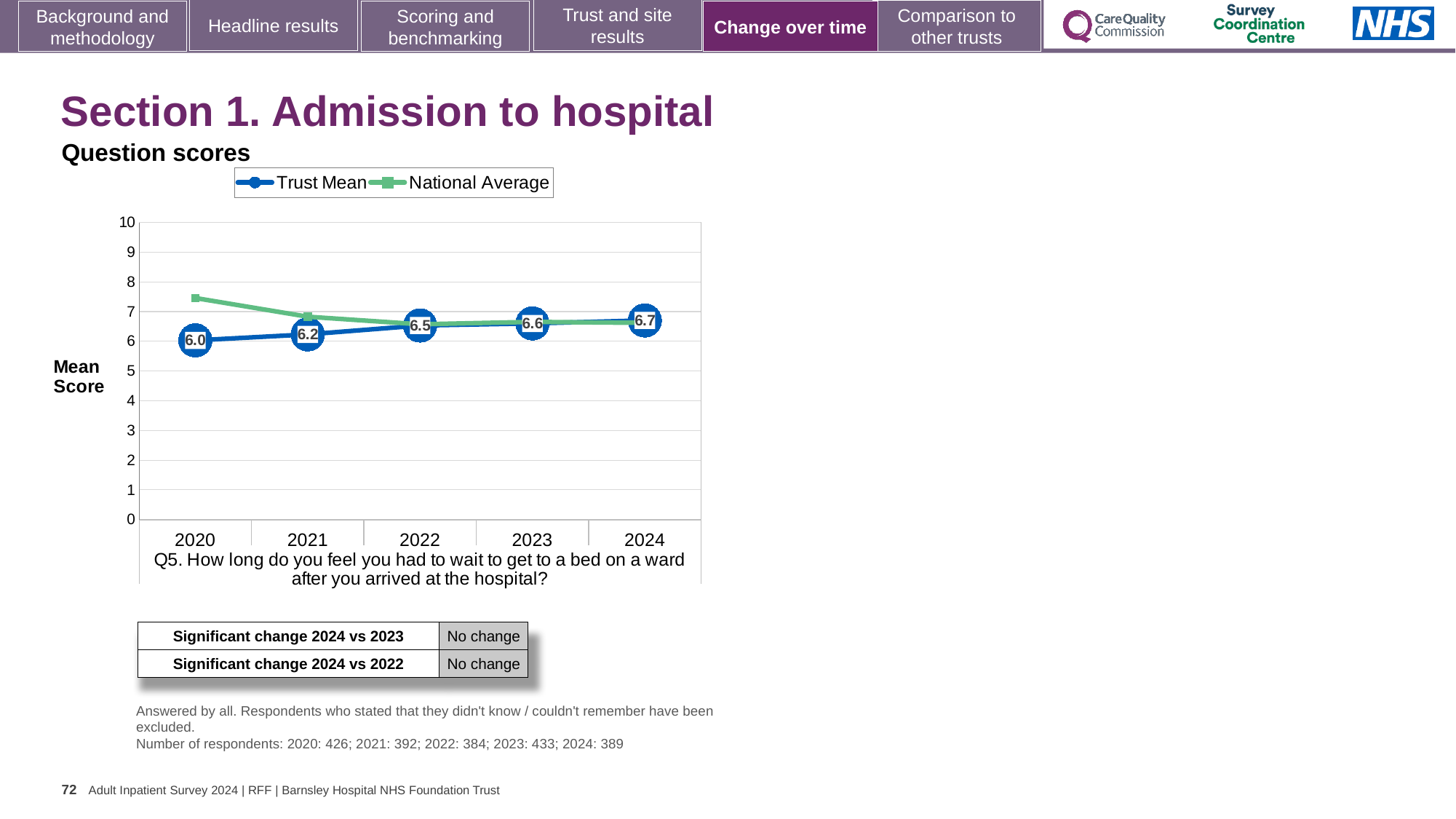
What is the Trust Mean score for 2020? 6.0 What is the Trust Mean score for 2022? 6.5 How many series does the chart legend list? 2 What is the difference between the Trust Mean score in 2024 and in 2020? 0.7 Does the Trust Mean rise or fall from 2020 to 2024? Rise In which year is the Trust Mean score highest? 2024 How many years are shown on the x axis of the chart? 5 What is the Trust Mean score for 2024? 6.7 What kind of chart is shown on the slide? Line chart Is the National Average value for 2020 greater or less than 7? greater In 2020, which is higher: the Trust Mean or the National Average? National Average In which year is the Trust Mean score lowest? 2020